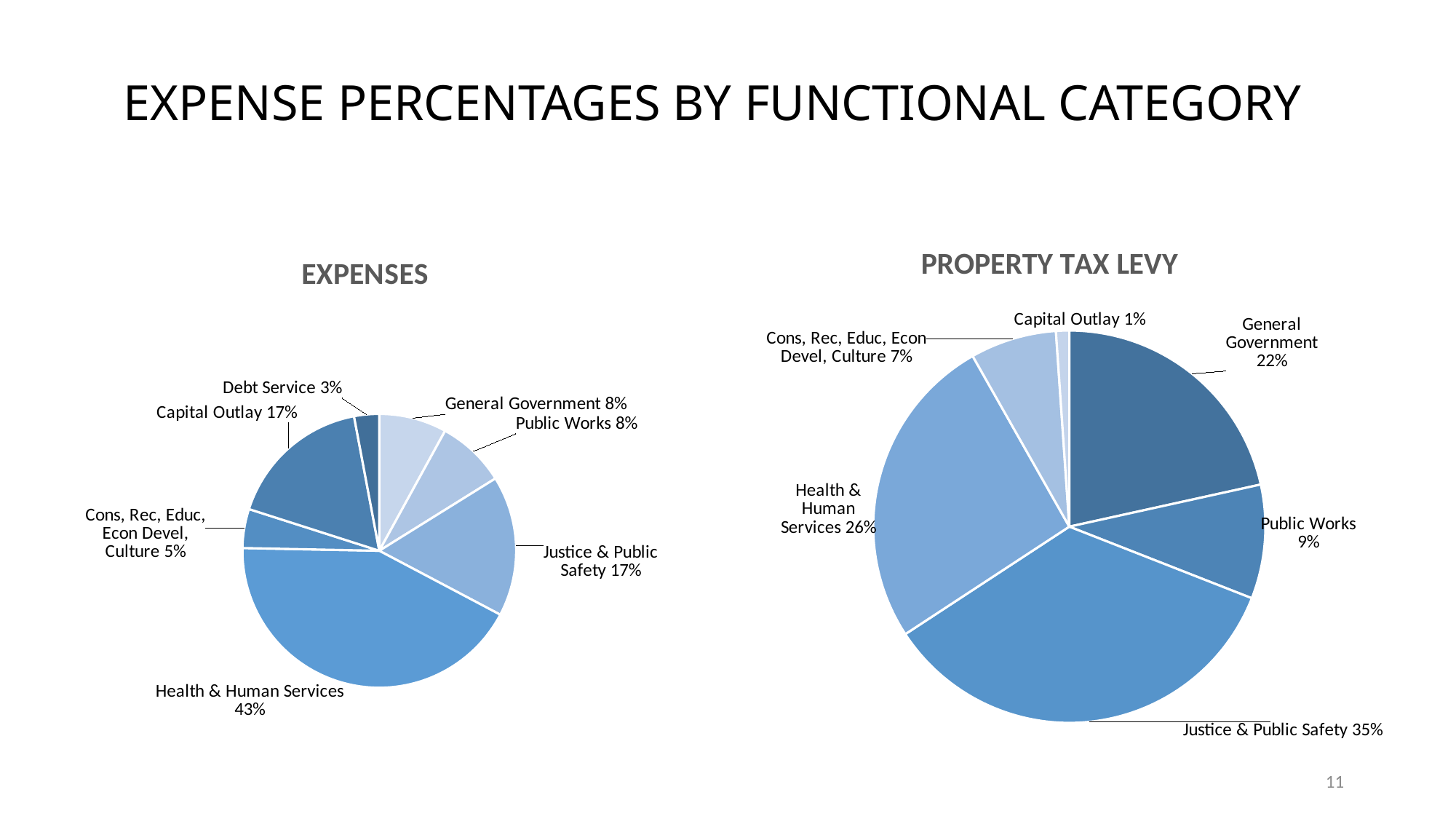
In the PROPERTY TAX LEVY chart, what percentage is Justice & Public Safety? 35% In the PROPERTY TAX LEVY chart, which category has the smallest share? Capital Outlay What type of chart is the PROPERTY TAX LEVY chart? Pie chart In the PROPERTY TAX LEVY chart, what percentage is General Government? 22% In the PROPERTY TAX LEVY chart, which category has the largest share? Justice & Public Safety In the EXPENSES chart, which category has the largest share? Health & Human Services How many slices does the EXPENSES pie chart have? 7 In the EXPENSES chart, what percentage is Debt Service? 3% What is the title of the chart on the left side of the slide? EXPENSES In the EXPENSES chart, what percentage is Health & Human Services? 43% In the PROPERTY TAX LEVY chart, which is larger: Health & Human Services or General Government? Health & Human Services In the EXPENSES chart, what is the difference between Health & Human Services and Capital Outlay? 26%